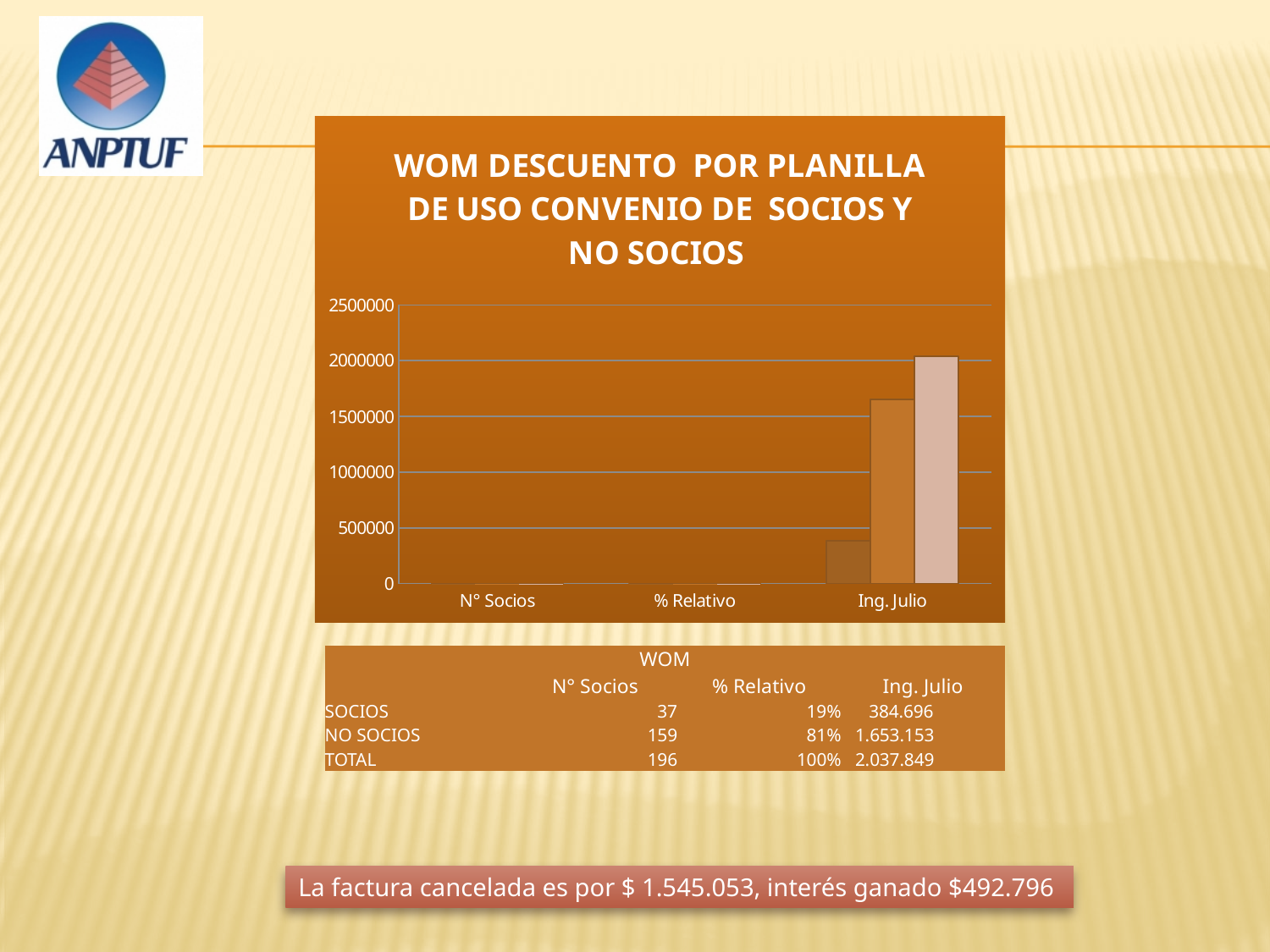
What is the title of the chart? WOM DESCUENTO POR PLANILLA DE USO CONVENIO DE SOCIOS Y NO SOCIOS What is the highest value shown on the chart's vertical axis? 2500000 In the Ing. Julio category, which is larger: the bar for SOCIOS or the bar for NO SOCIOS? NO SOCIOS According to the data table below the chart, what is the N° Socios value for NO SOCIOS? 159 What is the TOTAL Ing. Julio value shown in the data table? 2.037.849 What kind of chart is shown on the slide? bar chart How many categories are shown on the x axis of the chart? 3 In the Ing. Julio category, is the bar for NO SOCIOS greater or less than 1500000? greater According to the data table below the chart, what is the Ing. Julio value for NO SOCIOS? 1.653.153 What is the difference between the Ing. Julio values for NO SOCIOS and SOCIOS in the data table? 1.268.457 According to the data table below the chart, what is the Ing. Julio value for SOCIOS? 384.696 According to the data table below the chart, what is the % Relativo for SOCIOS? 19%